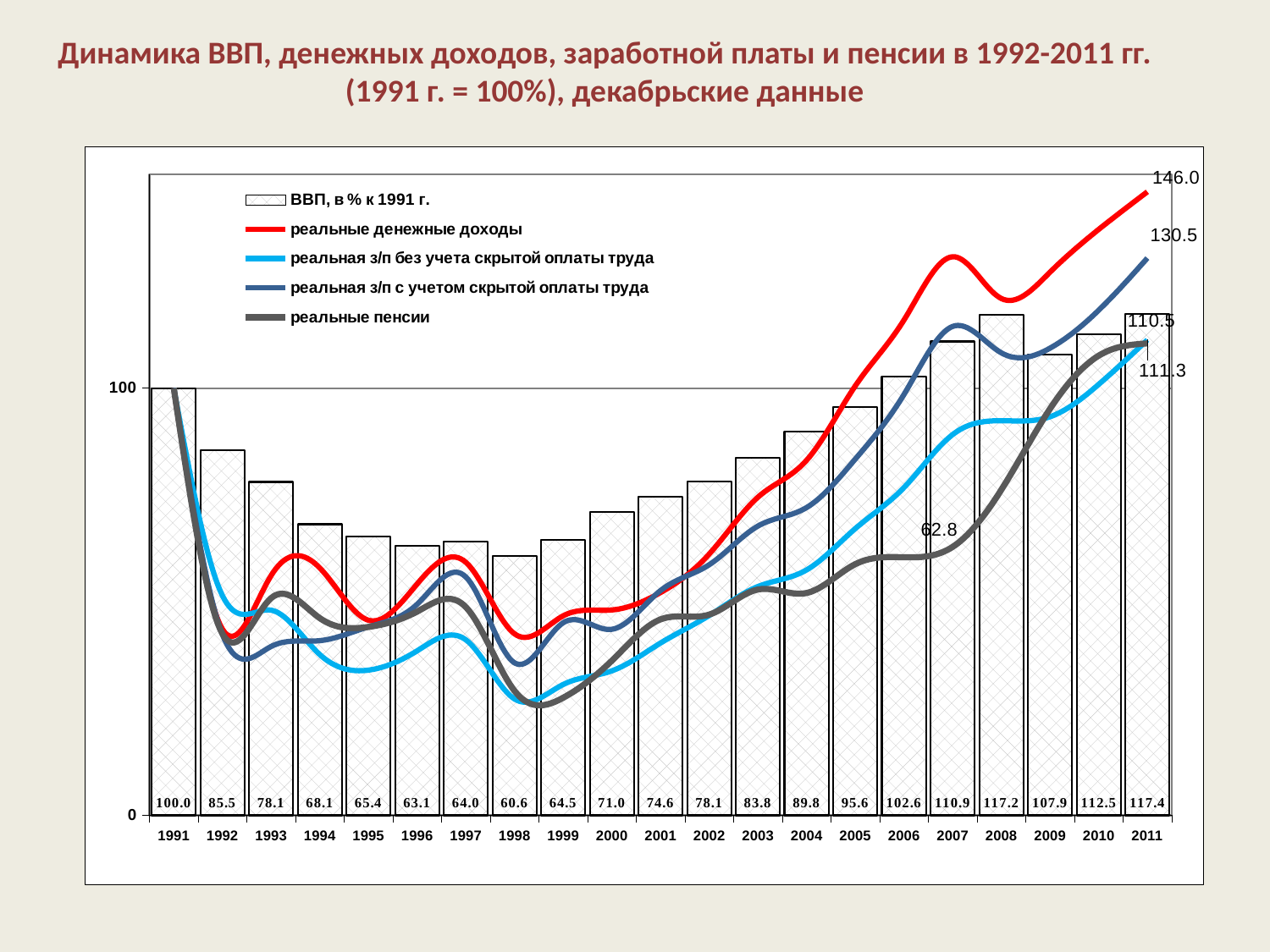
Which year has a higher ВВП, в % к 1991 г. value: 2007 or 2010? 2010 Does ВВП, в % к 1991 г. rise or fall from 1998 to 2008? rise How many series does the legend list? 5 What is the value of ВВП, в % к 1991 г. for 2006? 102.6 What is the value of ВВП, в % к 1991 г. for 1998? 60.6 What is the difference between ВВП, в % к 1991 г. in 2008 and in 2009? 9.3 In which year is ВВП, в % к 1991 г. lowest? 1998 What is the value of ВВП, в % к 1991 г. for 2011? 117.4 Is the value of реальные денежные доходы in 1998 greater or less than 100? less In which year is ВВП, в % к 1991 г. highest? 2011 What is the value of реальные денежные доходы in 2011? 146.0 How many years are shown on the x axis? 21